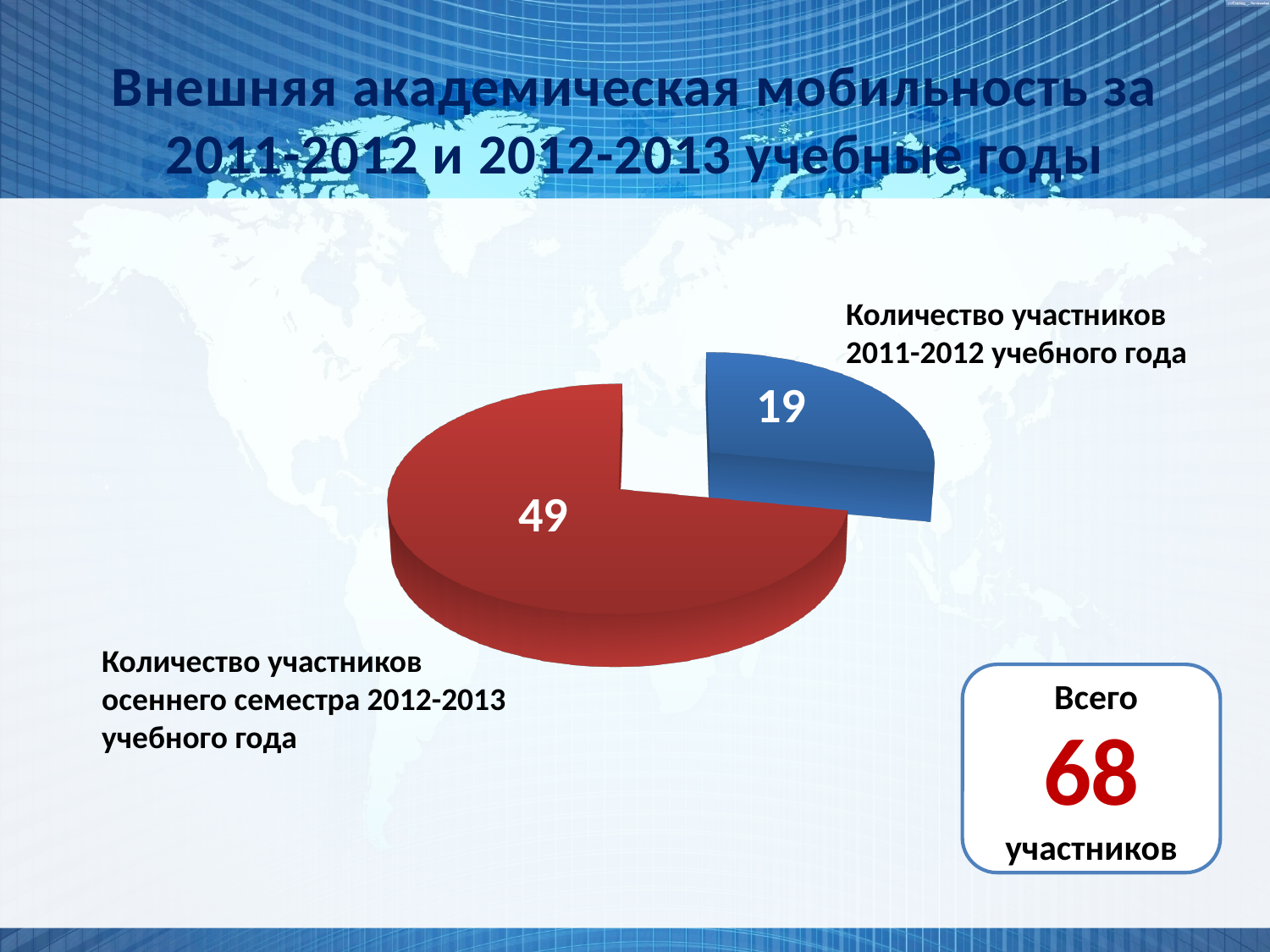
What is the number of participants for the 2011-2012 academic year? 19 Is the number of participants for 2011-2012 larger or smaller than the number for the fall semester of 2012-2013? Smaller How many slices does the pie chart have? 2 Which category has the larger slice in the pie chart? Количество участников осеннего семестра 2012-2013 учебного года What type of chart is shown on the slide? Pie chart What colour is the slice representing the 2011-2012 academic year participants? Blue What is the difference between the number of participants in the fall semester of 2012-2013 and in 2011-2012? 30 Which category has the smaller slice in the pie chart? Количество участников 2011-2012 учебного года What is the number of participants for the fall semester of the 2012-2013 academic year? 49 What is the total number of participants shown on the slide? 68 What fraction of the total 68 participants does the red slice (fall semester 2012-2013) represent? 49/68 What is the title of the slide? Внешняя академическая мобильность за 2011-2012 и 2012-2013 учебные годы